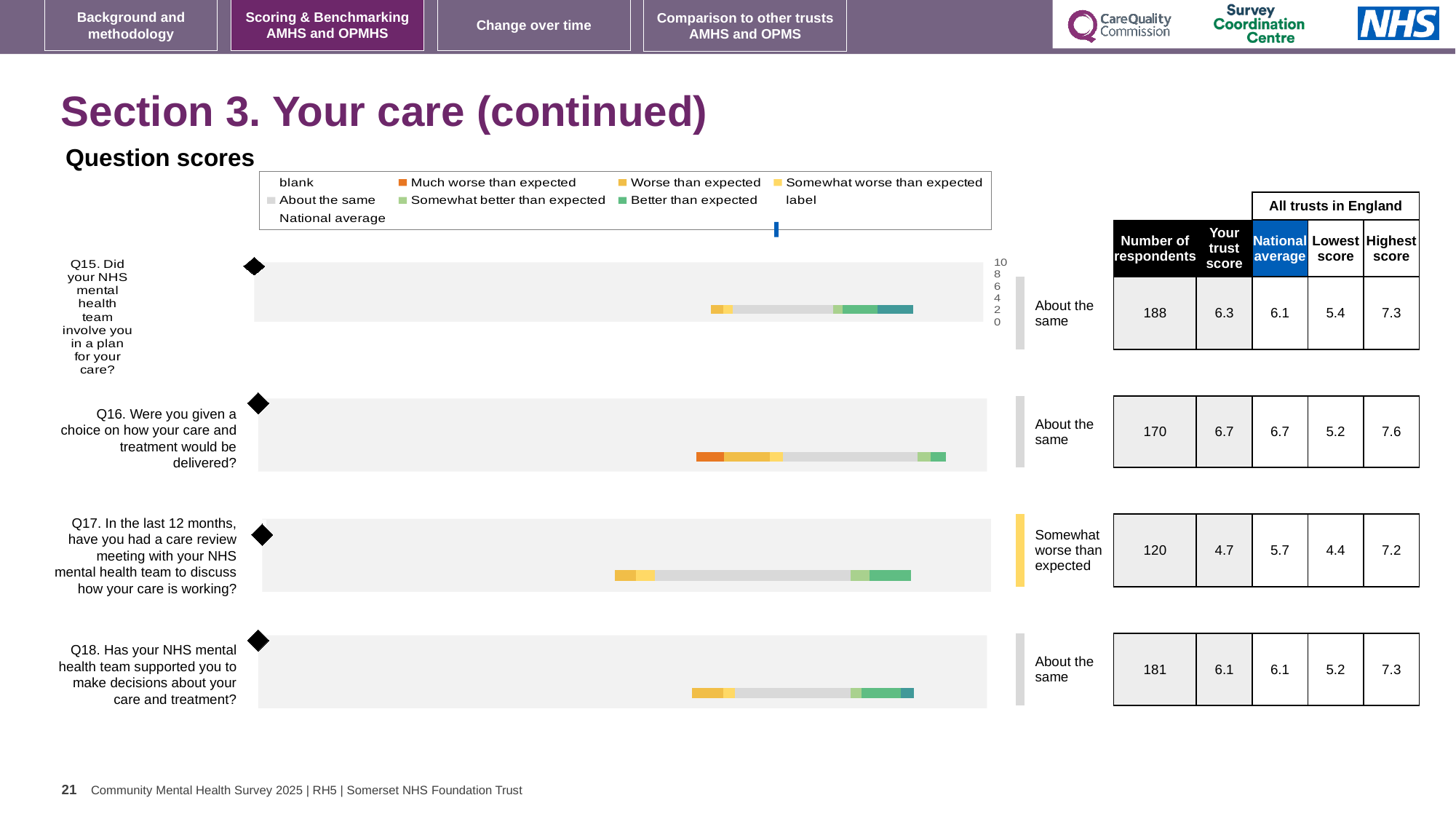
How many questions (charts) are shown on this slide? 4 Which question has the lowest number of respondents on this slide? Q17 For Q17, what is the difference between the national average and the trust score? 1.0 Which question has the highest trust score on this slide? Q16 For Q15, what is the difference between the highest score and the lowest score among all trusts in England? 1.9 What benchmark label is shown next to the chart for Q17? Somewhat worse than expected What is the highest score among all trusts in England shown for Q18 (supported you to make decisions about your care and treatment)? 7.3 What kind of chart is used to show the question scores on this slide? Bar chart How many respondents are shown for Q16 (Were you given a choice on how your care and treatment would be delivered?)? 170 Which is larger: the trust score for Q16 or the trust score for Q17? Q16 What is the trust score shown for Q15 (Did your NHS mental health team involve you in a plan for your care?)? 6.3 What is the national average shown for Q17 (care review meeting in the last 12 months)? 5.7